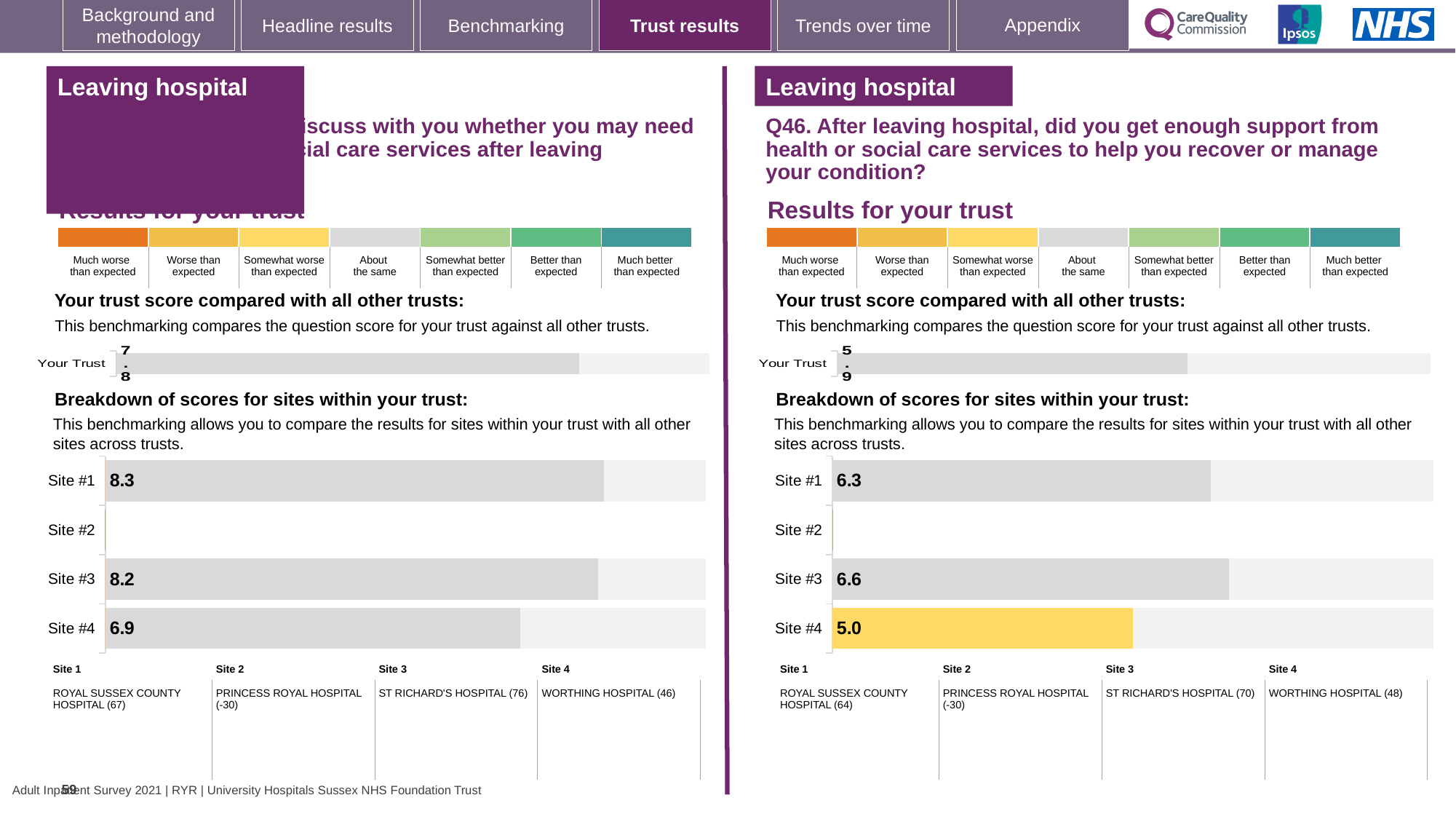
On the right-hand chart (Q46), which has the larger score, Site #1 or Site #3? Site #3 On the right-hand chart (Q46), what is the score for Site #4? 5.0 On the left-hand site breakdown chart, which site has the highest score? Site #1 On the left-hand site breakdown chart, what is the score for Site #4? 6.9 On the left-hand site breakdown chart, what is the difference between the scores for Site #1 and Site #4? 1.4 On the right-hand chart (Q46), what is the score for Site #1? 6.3 On the left-hand chart, what is the 'Your Trust' score? 7.8 On the right-hand chart (Q46), which site has the lowest score? Site #4 On the left-hand site breakdown chart, what is the score for Site #3? 8.2 What kind of chart is used for the site breakdown on the right-hand side (Q46)? Bar chart On the right-hand chart (Q46), what is the difference between the scores for Site #3 and Site #4? 1.6 On the right-hand chart (Q46), what is the 'Your Trust' score? 5.9